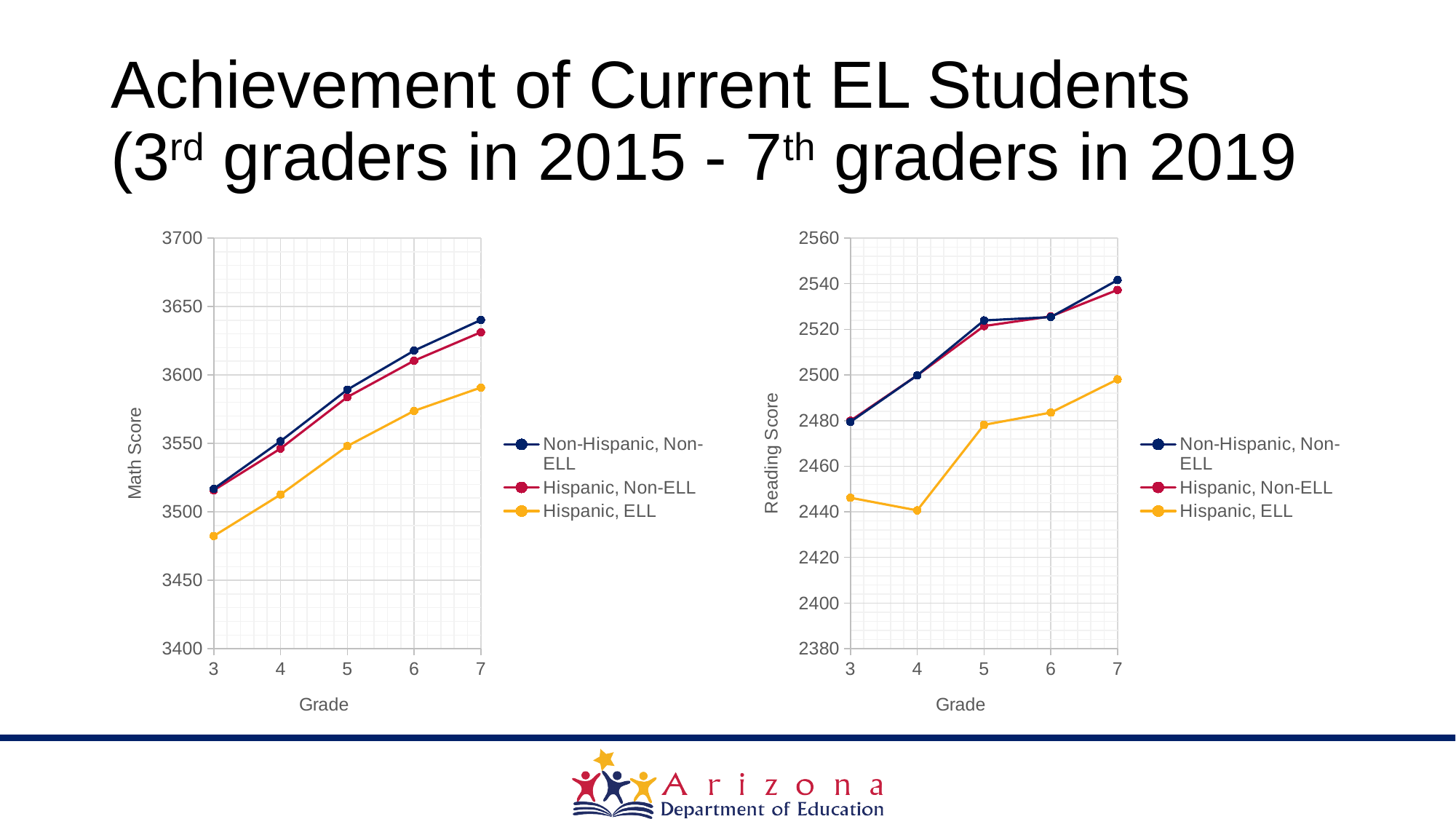
In the Math Score chart, which series has the highest value at grade 7? Non-Hispanic, Non-ELL How many series does the legend of the Reading Score chart list? 3 In the Reading Score chart, does the Hispanic, ELL line rise or fall from grade 3 to grade 4? fall In the Math Score chart, is the value for Hispanic, ELL at grade 3 greater or less than 3500? less In the Reading Score chart, at grade 5, which is larger: Hispanic, ELL or Hispanic, Non-ELL? Hispanic, Non-ELL In the Math Score chart, which series has the lowest value at every grade? Hispanic, ELL What is the y-axis title of the chart on the right? Reading Score What type of chart is the Math Score chart on the left? line chart In the Reading Score chart, is the value for Hispanic, ELL at grade 4 greater or less than 2460? less How many grade levels are plotted on the x axis of the Math Score chart? 5 In the Reading Score chart, is the value for Non-Hispanic, Non-ELL at grade 7 greater or less than 2520? greater